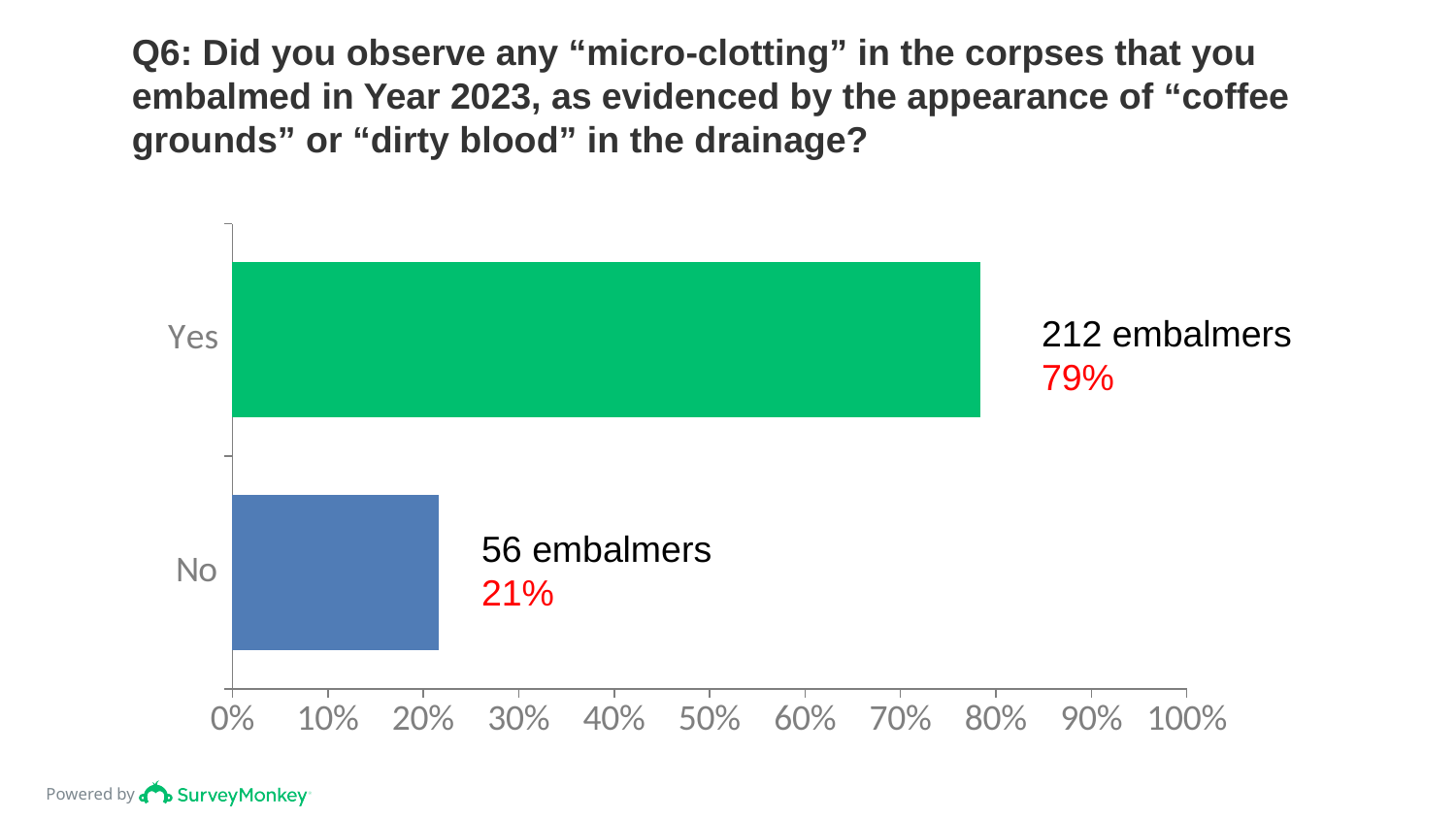
What percentage of embalmers answered "Yes"? 79% How many embalmers answered "No"? 56 embalmers What kind of chart is shown on the slide? bar chart How many embalmers answered "Yes"? 212 embalmers What percentage of embalmers answered "No"? 21% Which is larger, the value for "Yes" or the value for "No"? Yes How many more embalmers answered "Yes" than "No"? 156 What is the difference in percentage points between the "Yes" and "No" responses? 58% Which response category has the highest value? Yes How many response categories are shown in the chart? 2 Which response category has the lowest value? No Is the value for "No" greater or less than 30%? less